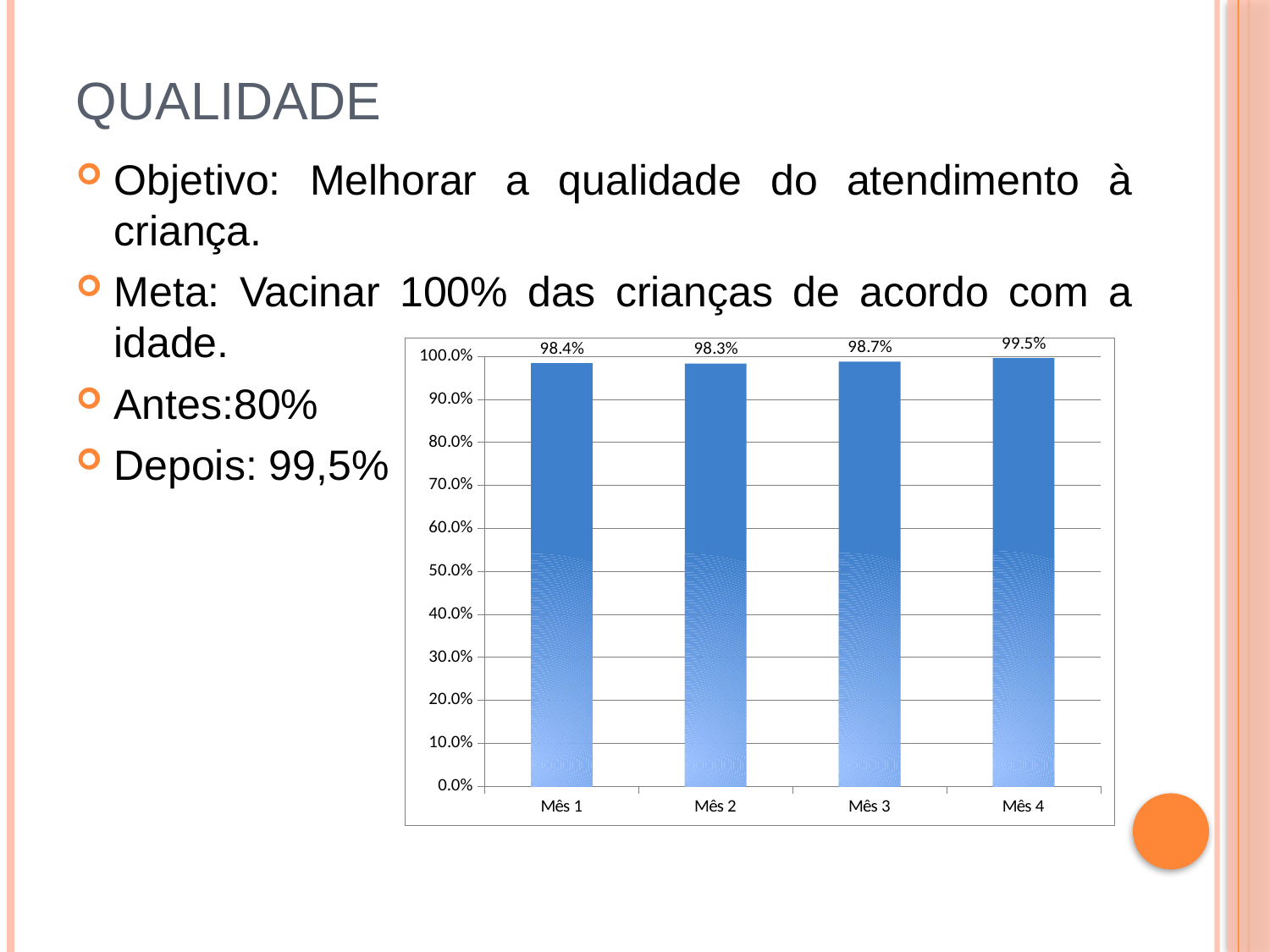
Which month has the highest value? Mês 4 Which is larger, the value for Mês 4 or the value for Mês 3? Mês 4 Is the value for Mês 2 greater or less than 90.0%? greater What is the difference between the values for Mês 4 and Mês 1? 1.1% What is the value for Mês 4? 99.5% How many months are shown on the x axis? 4 What kind of chart is shown on the slide? bar chart What is the value for Mês 3? 98.7% What is the value for Mês 1? 98.4% Which month has the lowest value? Mês 2 What is the value for Mês 2? 98.3% What is the difference between the values for Mês 3 and Mês 2? 0.4%